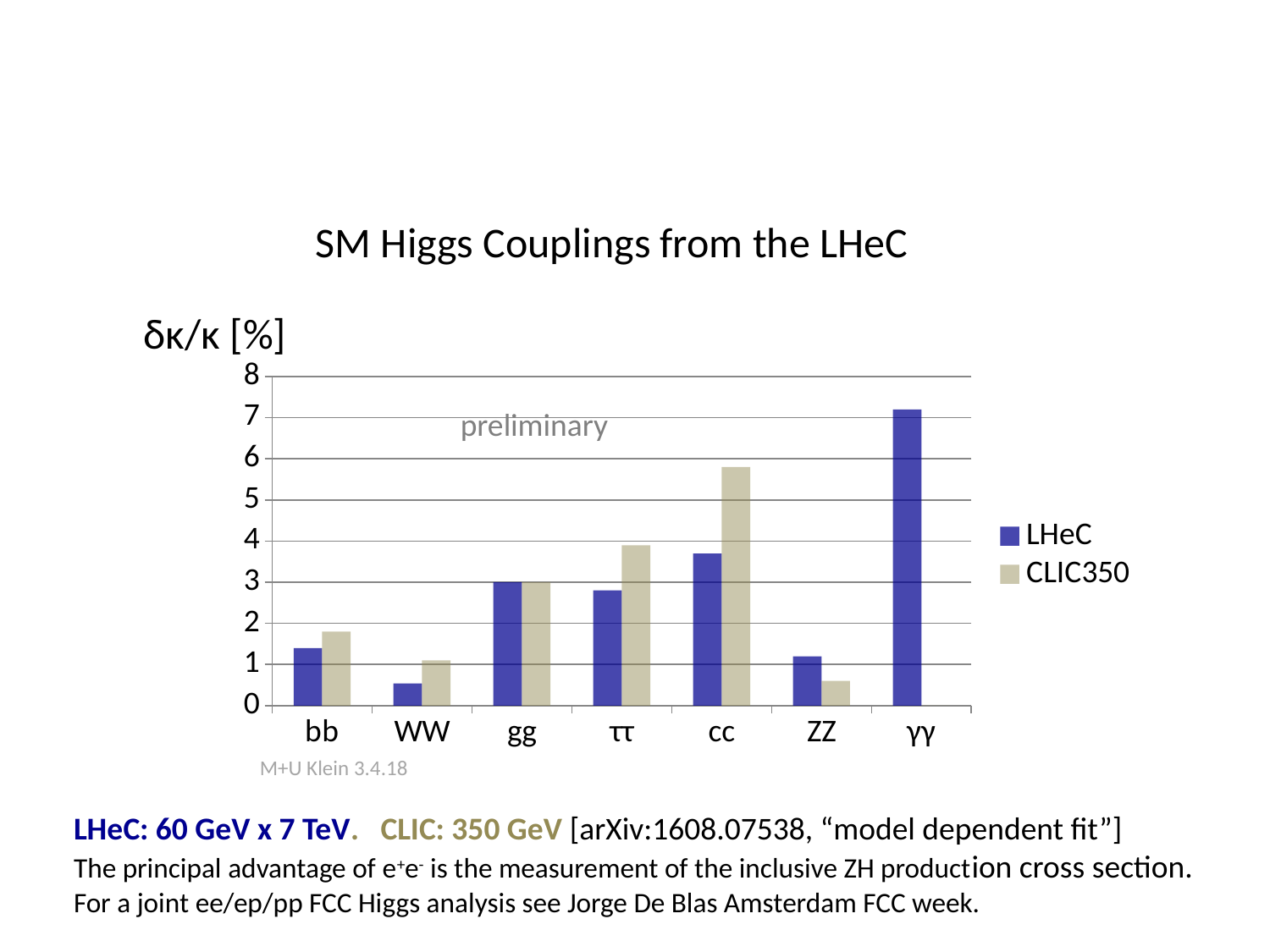
How many categories are shown on the x axis? 7 Is the LHeC value for WW greater or less than 1? less How many series does the legend list? 2 Which category has the highest CLIC350 value? cc Which category has the lowest LHeC value? WW What is the title of the chart? SM Higgs Couplings from the LHeC Which category has the highest LHeC value? γγ For cc, which series has the larger value, LHeC or CLIC350? CLIC350 For ZZ, which series has the larger value, LHeC or CLIC350? LHeC Is the LHeC value for γγ greater or less than 7? greater Which category has the lowest CLIC350 value among those with a CLIC350 bar? ZZ What kind of chart is shown on the slide? bar chart